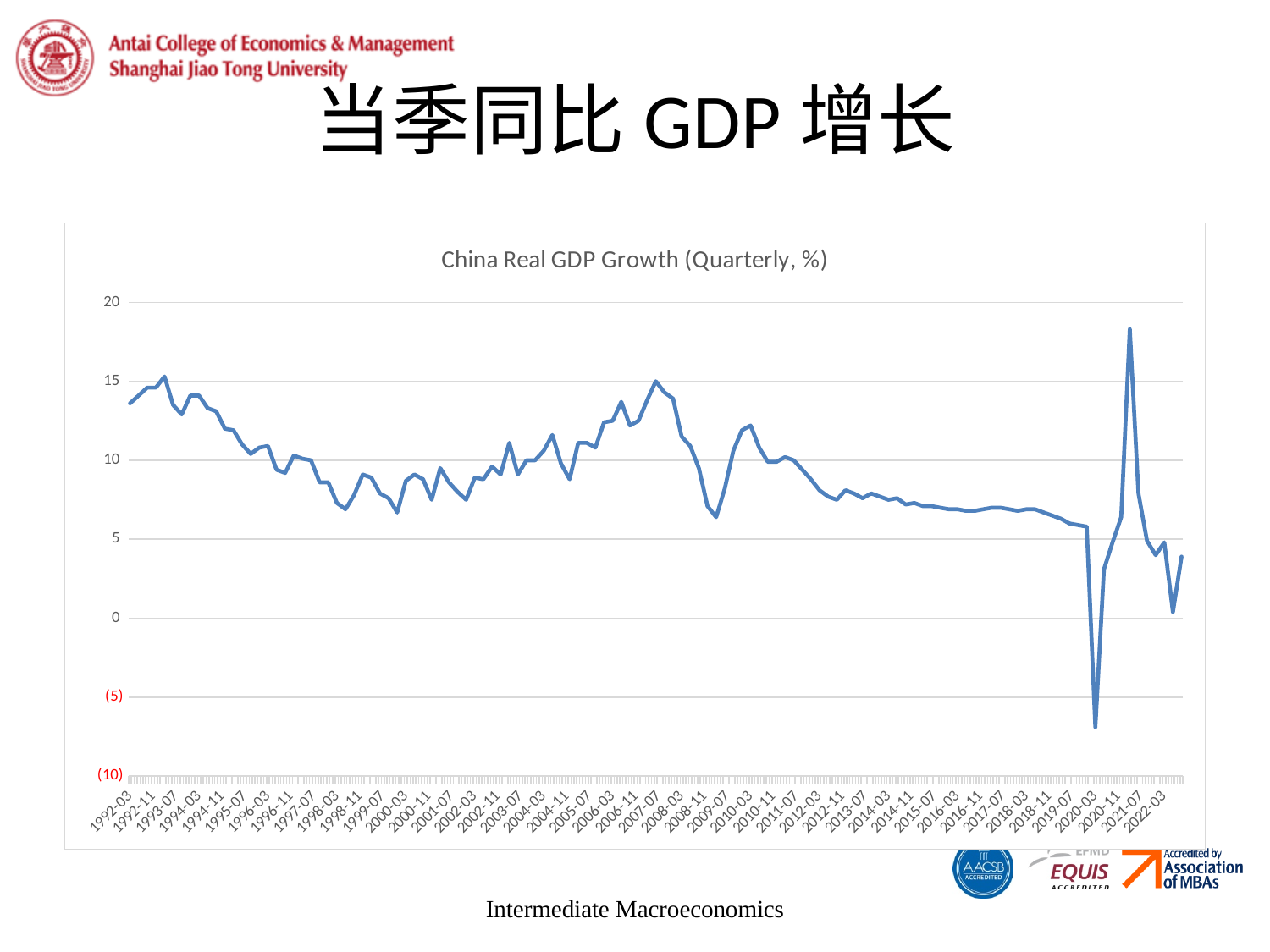
Does the line generally rise or fall from 2007-07 to 2019-07? fall Is the value for 2016-03 greater or less than 10? less Is the value for 2020-03 greater or less than 0? less What is the title of the chart? China Real GDP Growth (Quarterly, %) Is the value for 2007-07 greater or less than 10? greater Which is larger, the value for 1992-03 or the value for 2022-03? 1992-03 What kind of chart is shown on the slide? line chart In which year does the line reach its highest value? 2021 In which year does the line reach its lowest value? 2020